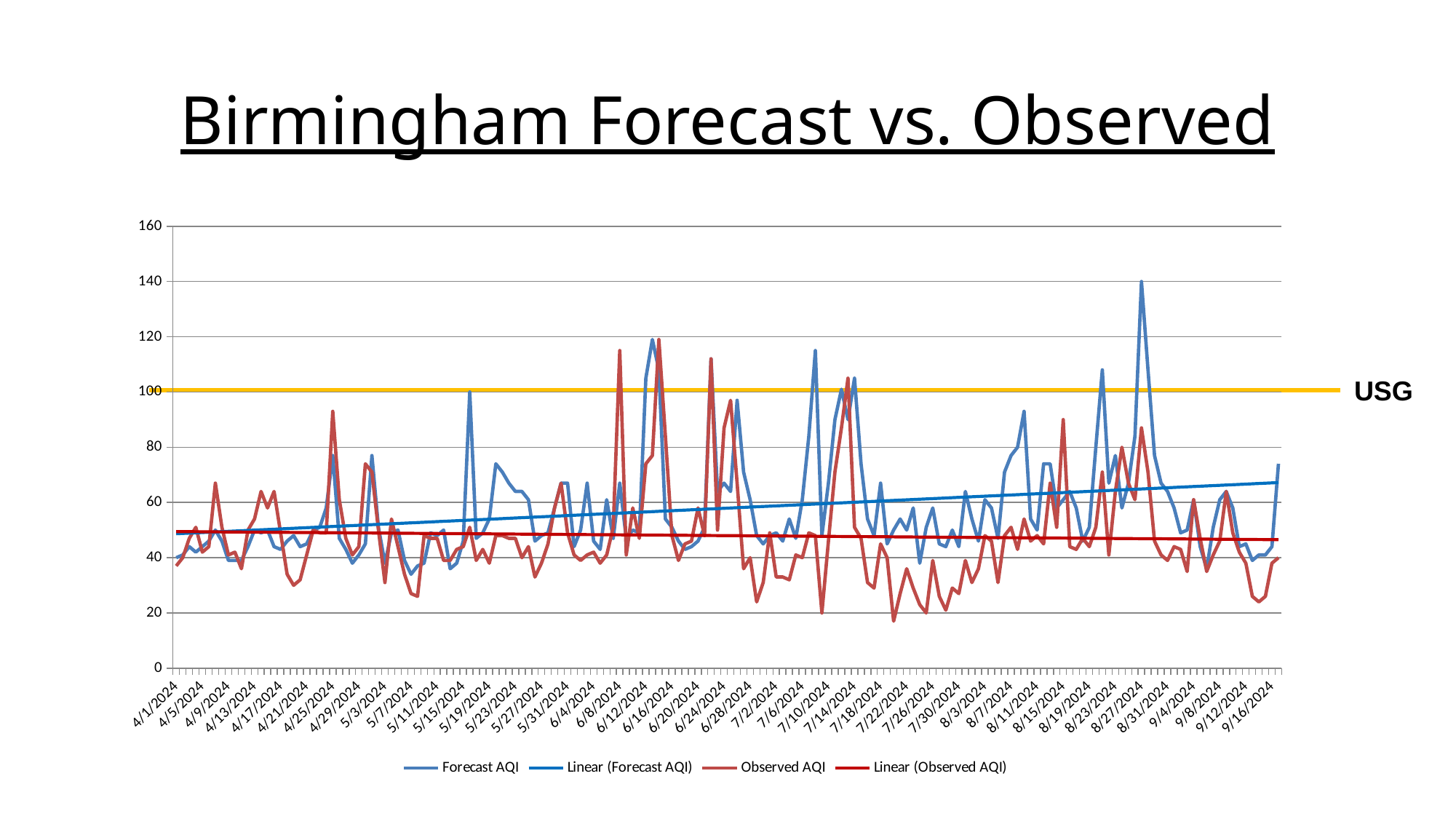
Does the Linear (Forecast AQI) trend line rise or fall from left to right? rise At what AQI value is the horizontal USG line drawn? 100 How many series does the legend list? 4 What is the title of the chart? Birmingham Forecast vs. Observed What kind of chart is shown on the slide? line chart Which series reaches the highest peak on the chart, Forecast AQI or Observed AQI? Forecast AQI What colour is the USG line on the chart? yellow Is the highest Forecast AQI peak (near 8/27/2024) greater or less than 120? greater Near 8/27/2024, which is larger, the Forecast AQI or the Observed AQI? Forecast AQI Is the Observed AQI peak near 4/25/2024 greater or less than 80? greater What is the highest value shown on the vertical axis? 160 Is the Observed AQI peak near 6/16/2024 greater or less than 100? greater